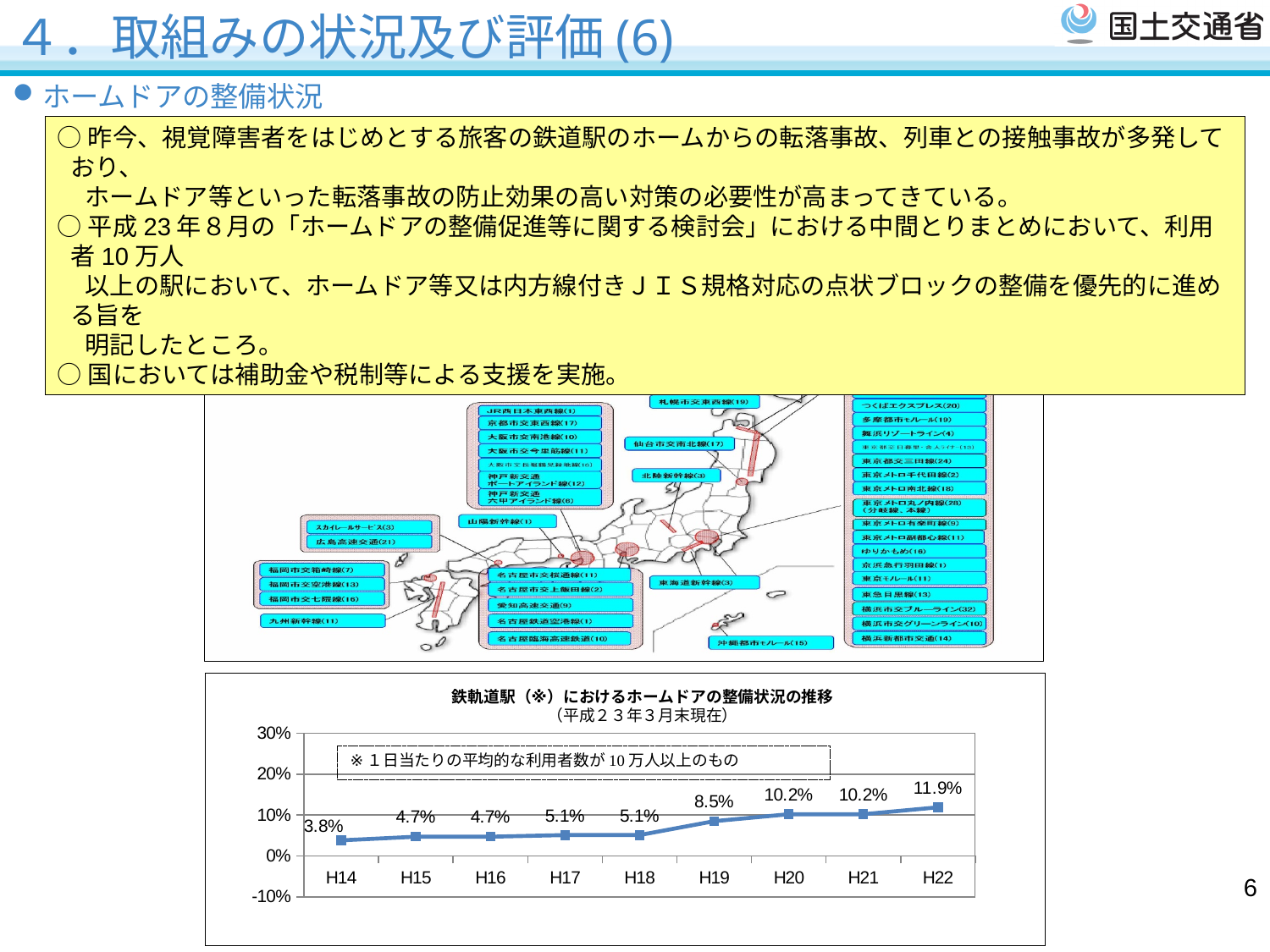
In the line chart at the bottom of the slide, which year has the lowest value? H14 In the line chart at the bottom of the slide, do the values generally rise or fall from H14 to H22? Rise In the line chart at the bottom of the slide, what is the value for H14? 3.8% In the line chart at the bottom of the slide, what is the difference between the values for H19 and H18? 3.4% In the line chart at the bottom of the slide, which year has the highest value? H22 In the line chart at the bottom of the slide, what is the difference between the values for H22 and H14? 8.1% In the line chart at the bottom of the slide, is the value for H22 greater or less than 10%? greater In the line chart at the bottom of the slide, what is the value for H19? 8.5% In the line chart at the bottom of the slide, which is larger, the value for H20 or the value for H18? H20 What kind of chart is shown at the bottom of the slide? Line chart How many years (data points) are plotted in the line chart at the bottom of the slide? 9 In the line chart at the bottom of the slide, what is the value for H22? 11.9%